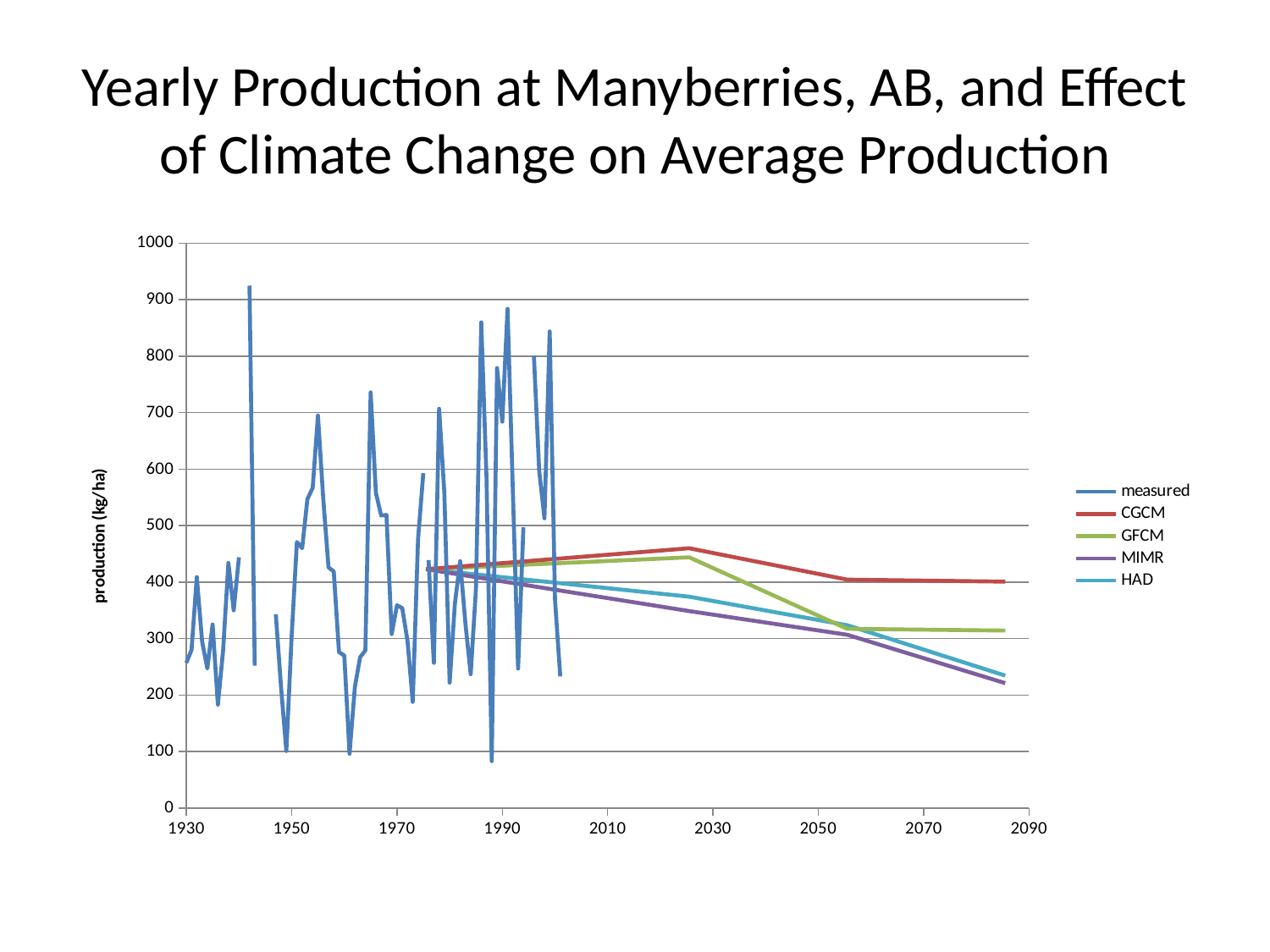
Is the value for CGCM at 2025 greater or less than 400? greater At 2085, which is larger, GFCM or HAD? GFCM Is the value for HAD at 2085 greater or less than 300? less Which series has the highest value at 2085? CGCM What kind of chart is shown on the slide? line chart What is the label on the vertical axis? production (kg/ha) Is the lowest value of the measured series greater or less than 100? less Which series is plotted in blue according to the legend? measured Does the MIMR series rise or fall from 1975 to 2085? fall How many series does the legend list? 5